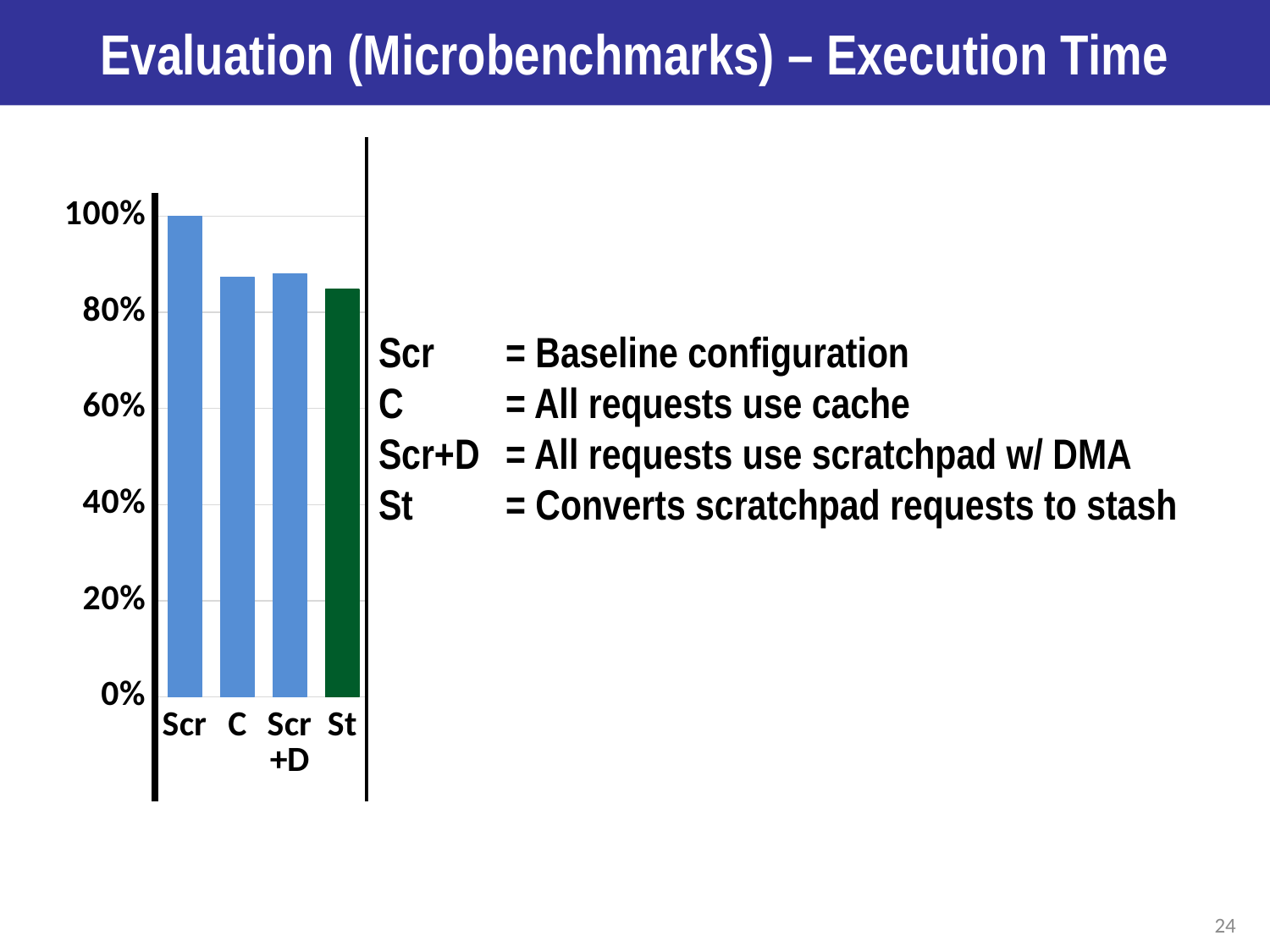
Which bar in the chart is coloured green rather than blue? St Which is larger, the value for Scr or the value for St? Scr What kind of chart is shown on the slide? bar chart Is the value for C greater or less than 80%? greater According to the slide, what does the label St stand for? Converts scratchpad requests to stash Is the value for St greater or less than 100%? less Which category has the highest value in the chart? Scr How many bars (categories) does the chart show? 4 Is the value for St greater or less than 80%? greater Which is larger, the value for C or the value for Scr? Scr What is the value for Scr? 100%